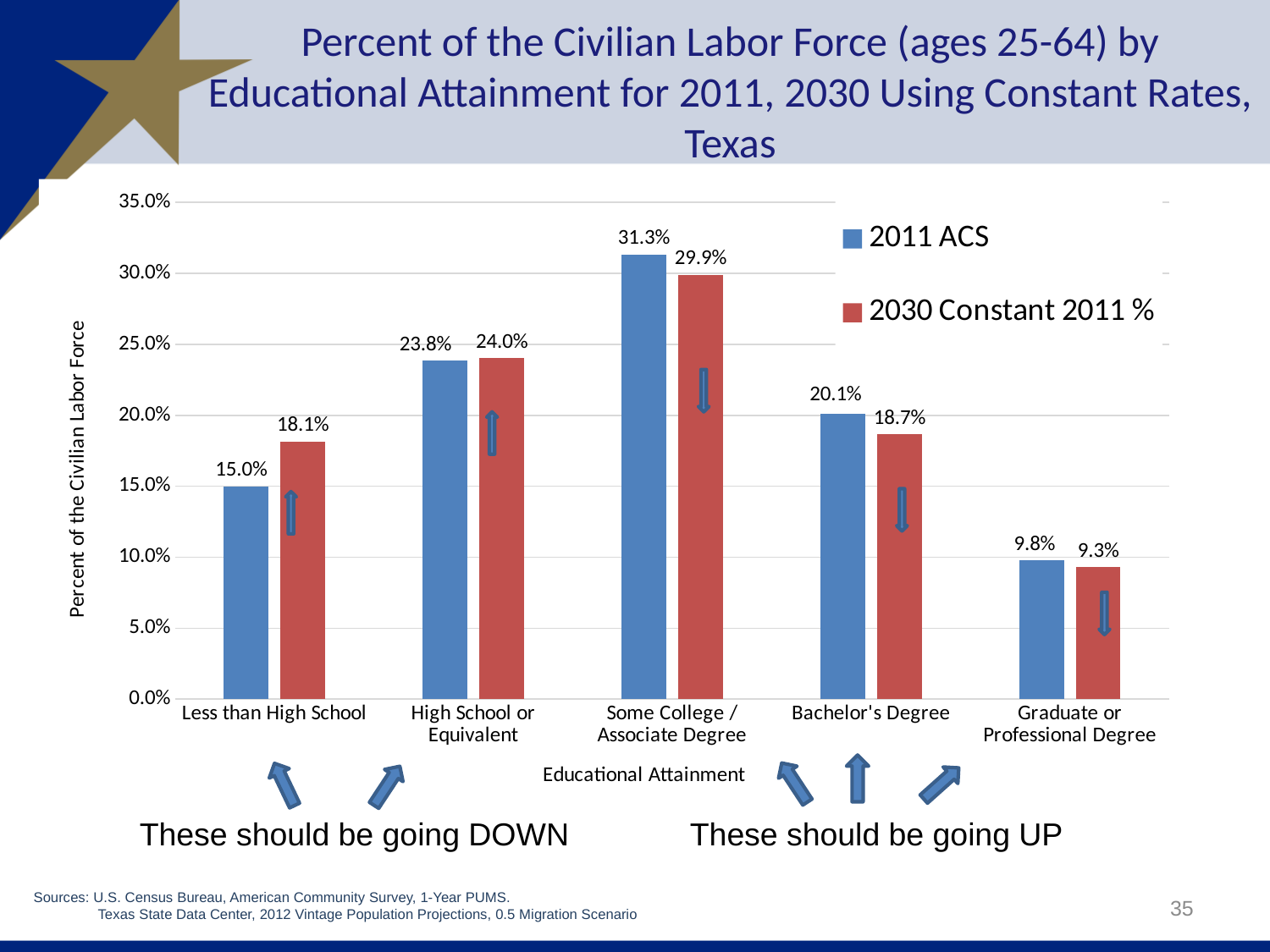
What is the difference between the 2011 ACS and 2030 Constant 2011 % values for Less than High School? 3.1% What is the 2011 ACS value for Some College / Associate Degree? 31.3% Which educational attainment category has the highest 2011 ACS value? Some College / Associate Degree Is the 2011 ACS value for High School or Equivalent greater or less than 25.0%? less What kind of chart is shown on the slide? Bar chart How many educational attainment categories are shown on the x axis? 5 Which educational attainment category has the lowest 2030 Constant 2011 % value? Graduate or Professional Degree Which is larger for Bachelor's Degree: the 2011 ACS value or the 2030 Constant 2011 % value? 2011 ACS What is the label of the y axis? Percent of the Civilian Labor Force What is the 2011 ACS value for Bachelor's Degree? 20.1% What is the 2030 Constant 2011 % value for Less than High School? 18.1% How many series does the legend list? 2